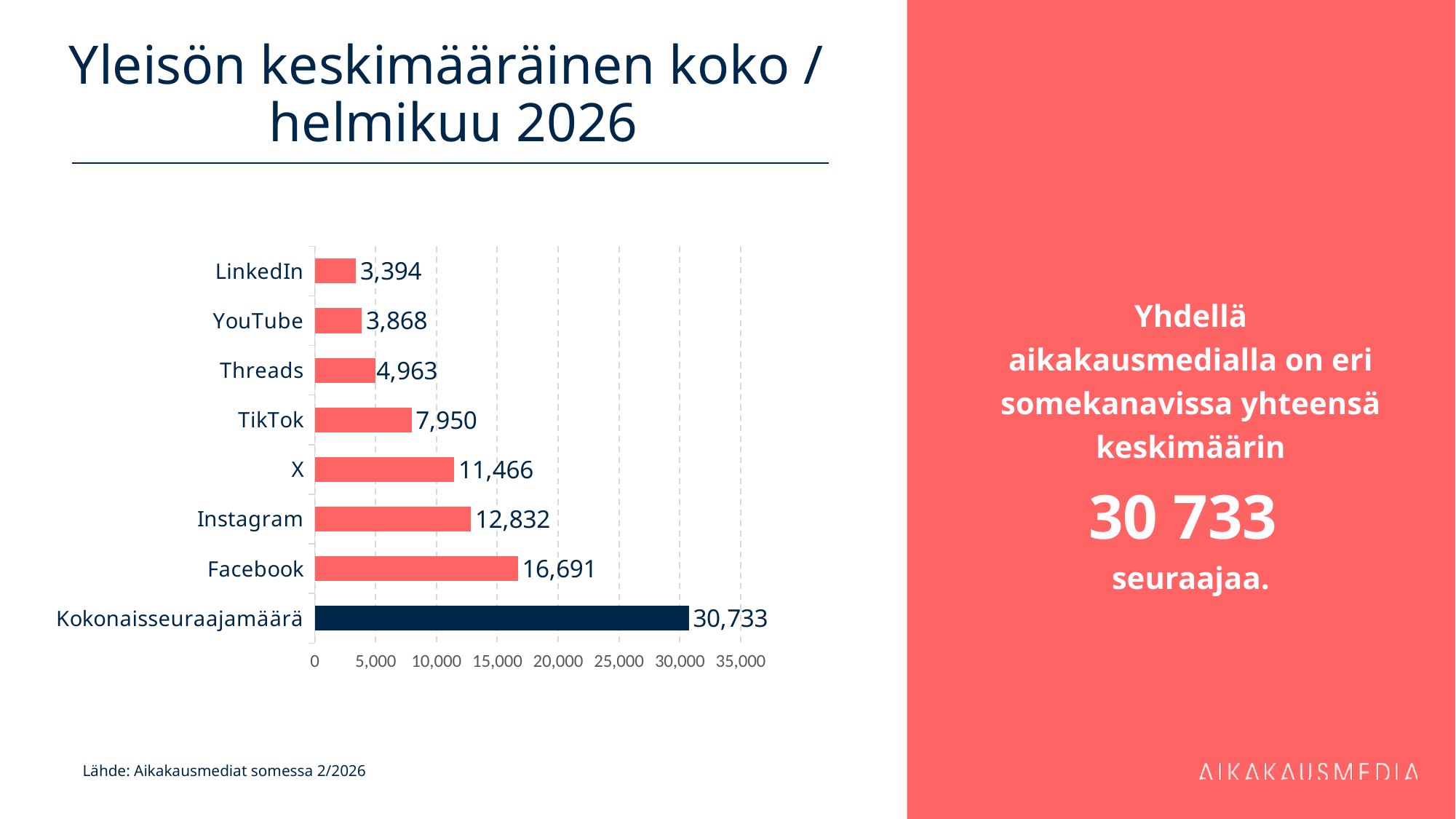
What is the value for Facebook? 16,691 What is the difference between the values for Instagram and X? 1,366 Which is larger, the value for YouTube or the value for Threads? Threads What is the title of the slide containing the chart? Yleisön keskimääräinen koko / helmikuu 2026 What is the value for Kokonaisseuraajamäärä? 30,733 What is the difference between the values for Facebook and Instagram? 3,859 How many categories are shown in the chart? 8 What kind of chart is shown on the slide? bar chart Which category has the lowest value? LinkedIn Which individual platform (excluding Kokonaisseuraajamäärä) has the highest value? Facebook What is the value for TikTok? 7,950 Is the value for X greater or less than 10,000? greater